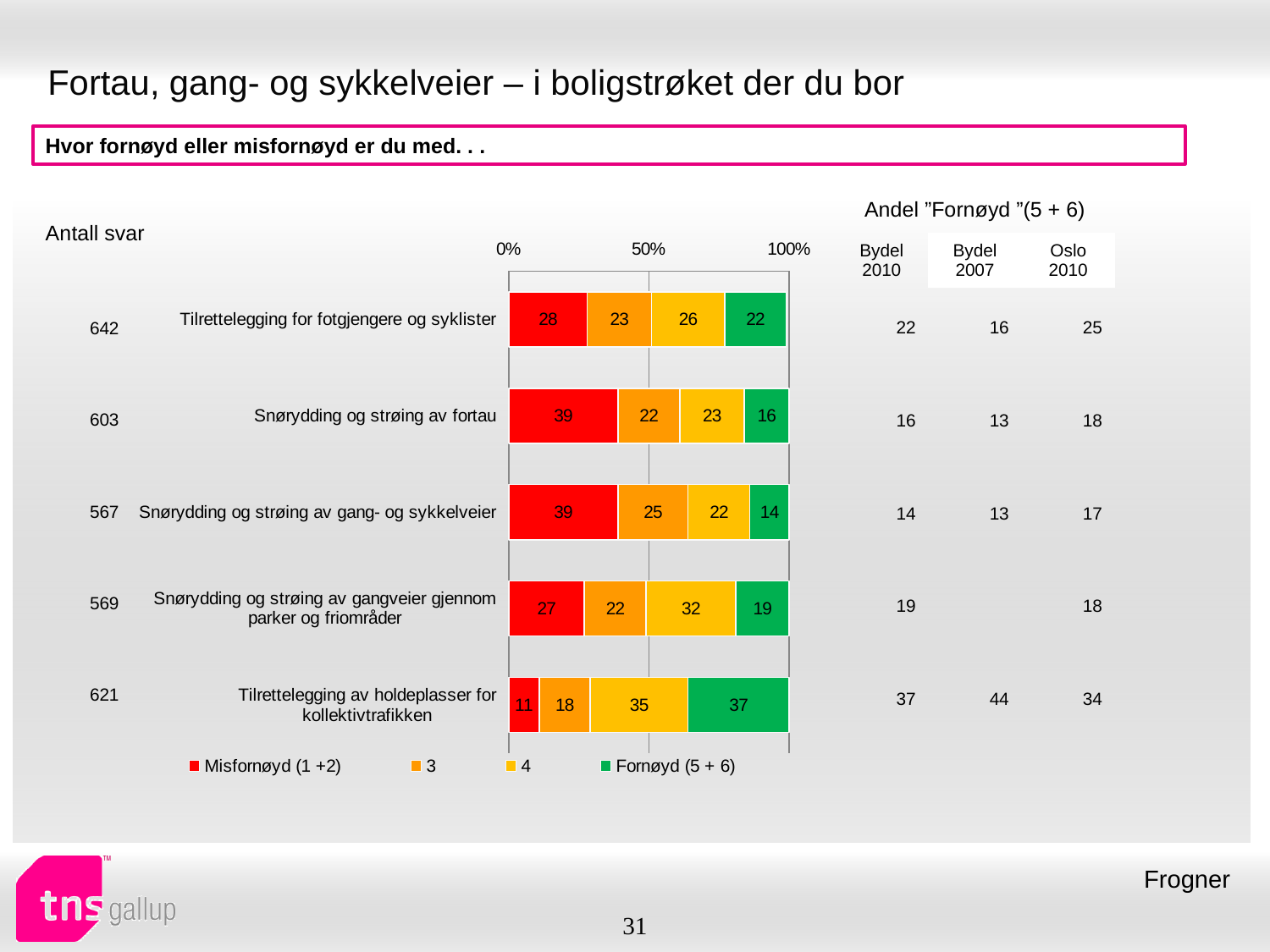
What is the total of the stacked bar for 'Tilrettelegging for fotgjengere og syklister'? 99 What kind of chart is shown on the slide? Stacked bar chart What is the value of the Misfornøyd (1 +2) segment for 'Snørydding og strøing av fortau'? 39 Which colour represents the Fornøyd (5 + 6) series in the chart? Green What is the value of the '4' segment for 'Snørydding og strøing av gangveier gjennom parker og friområder'? 32 What is the difference between the Misfornøyd (1 +2) value for 'Snørydding og strøing av fortau' and for 'Tilrettelegging for fotgjengere og syklister'? 11 What is the value of the Fornøyd (5 + 6) segment for 'Tilrettelegging av holdeplasser for kollektivtrafikken'? 37 How many categories are plotted in the chart? 5 Which is larger: the Fornøyd (5 + 6) value for 'Snørydding og strøing av fortau' or for 'Snørydding og strøing av gang- og sykkelveier'? Snørydding og strøing av fortau Which category has the lowest Misfornøyd (1 +2) value? Tilrettelegging av holdeplasser for kollektivtrafikken Which category has the highest Fornøyd (5 + 6) value? Tilrettelegging av holdeplasser for kollektivtrafikken How many series does the chart legend list? 4